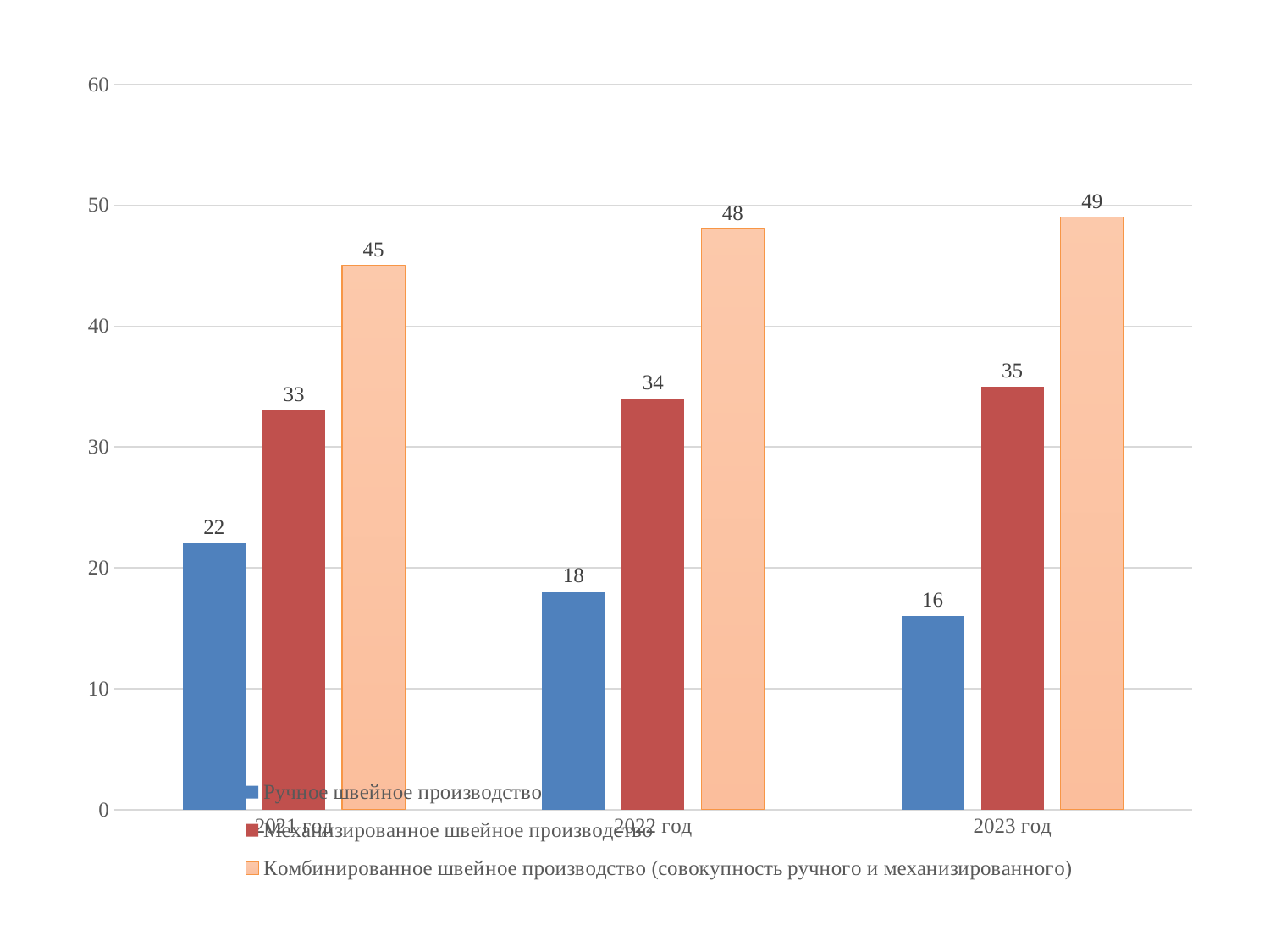
In which year is the value for Ручное швейное производство the lowest? 2023 год Do the values for Ручное швейное производство rise or fall from 2021 год to 2023 год? fall In which year is the value for Комбинированное швейное производство the highest? 2023 год What is the value for Комбинированное швейное производство in 2023 год? 49 How many series does the legend list? 3 What is the value for Ручное швейное производство in 2021 год? 22 What is the difference between the Комбинированное швейное производство value and the Ручное швейное производство value in 2021 год? 23 Is the value for Комбинированное швейное производство in 2022 год greater or less than 40? greater What is the value for Механизированное швейное производство in 2022 год? 34 Which is larger in 2022 год: Ручное швейное производство or Механизированное швейное производство? Механизированное швейное производство How many years are shown on the x axis? 3 What kind of chart is shown on the slide? bar chart